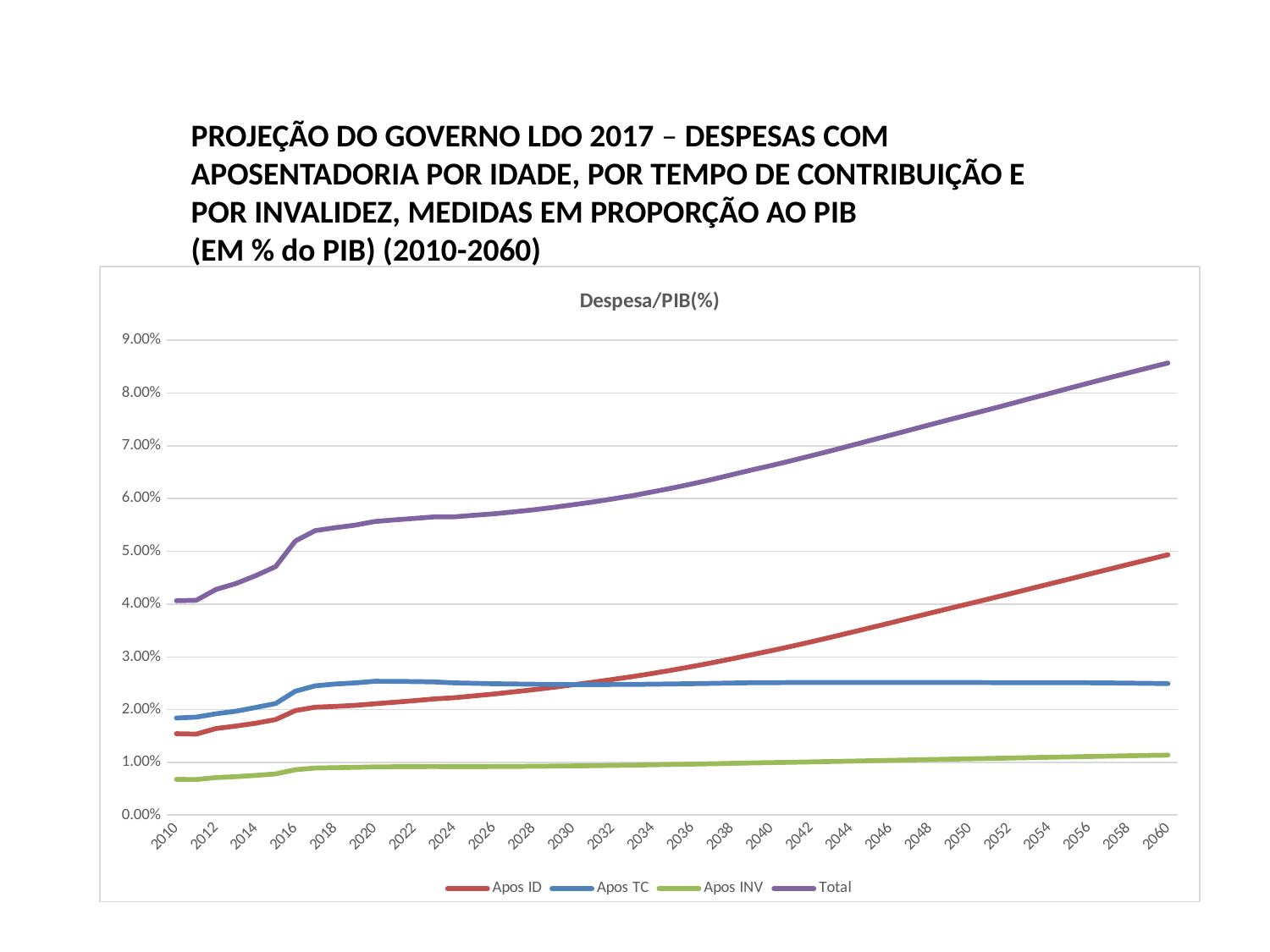
What kind of chart is shown on the slide? line chart In 2060, which is larger: Apos ID or Apos TC? Apos ID Which series has the highest value in 2060? Total Is the value of Total in 2010 greater or less than 5.00%? less Which series has the lowest values across the whole period? Apos INV Is the value of Total in 2060 greater or less than 8.00%? greater Is the value of Apos TC in 2060 greater or less than 3.00%? less What is the title shown inside the chart area? Despesa/PIB(%) Does the Total series rise or fall from 2010 to 2060? rise How many series does the legend list? 4 Which series are listed in the chart legend? Apos ID, Apos TC, Apos INV, Total